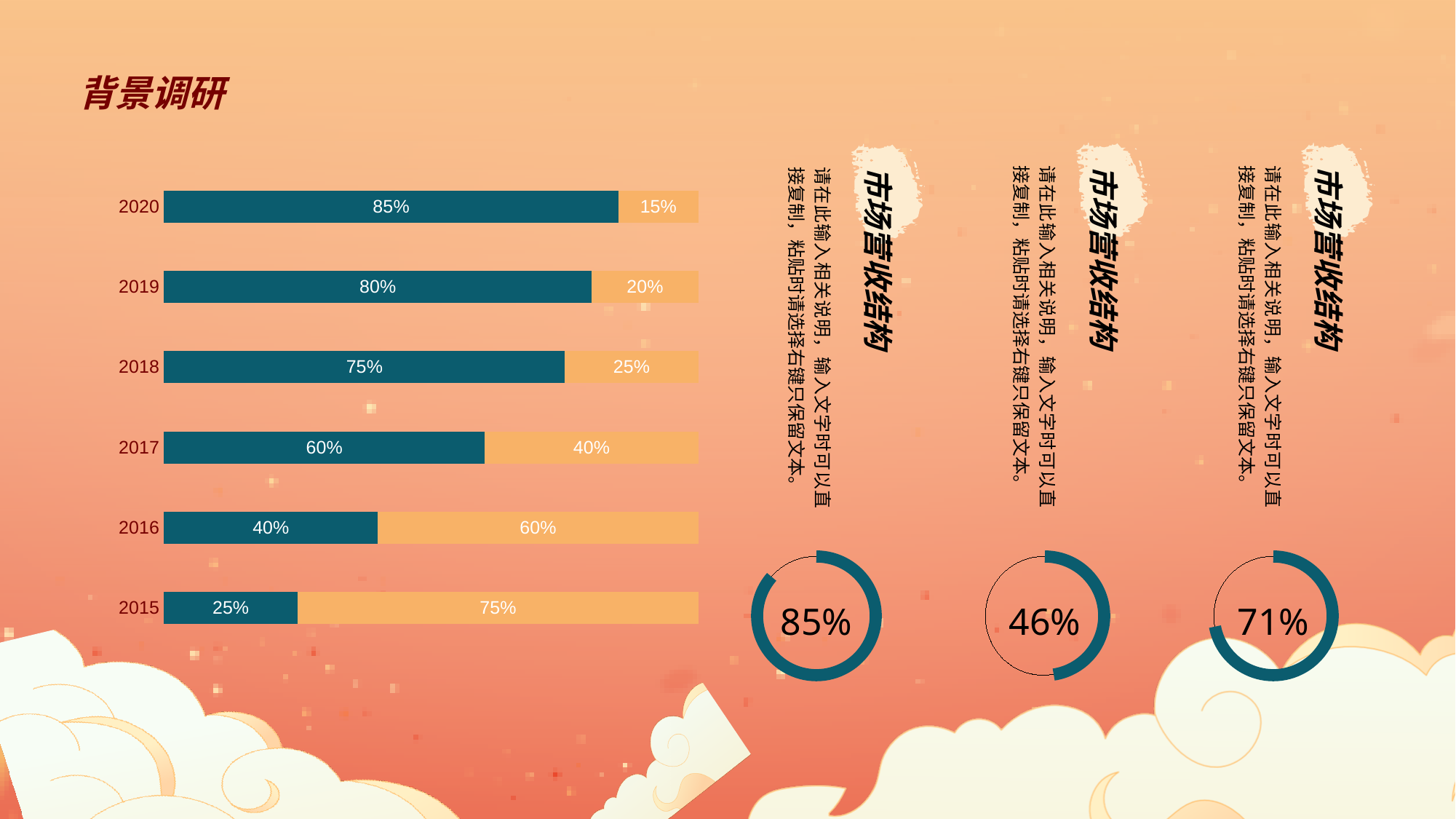
In the bar chart on the left, do the teal values rise or fall from 2015 to 2020? rise In the bar chart on the left, what is the value of the orange segment for 2016? 60% How many years are shown in the bar chart on the left? 6 In the bar chart on the left, for 2017, which segment is larger, the teal one or the orange one? the teal one (60%) In the bar chart on the left, what is the difference between the teal values for 2019 and 2018? 5% How many series are stacked in each bar of the bar chart on the left? 2 In the bar chart on the left, what is the total of the two segments for 2018? 100% What value is shown in the middle ring chart on the right of the slide? 46% In the bar chart on the left, which year has the smallest teal segment? 2015 In the bar chart on the left, what is the value of the teal segment for 2020? 85% In the bar chart on the left, which year has the largest teal segment? 2020 What kind of chart is shown on the left of the slide? a stacked bar chart